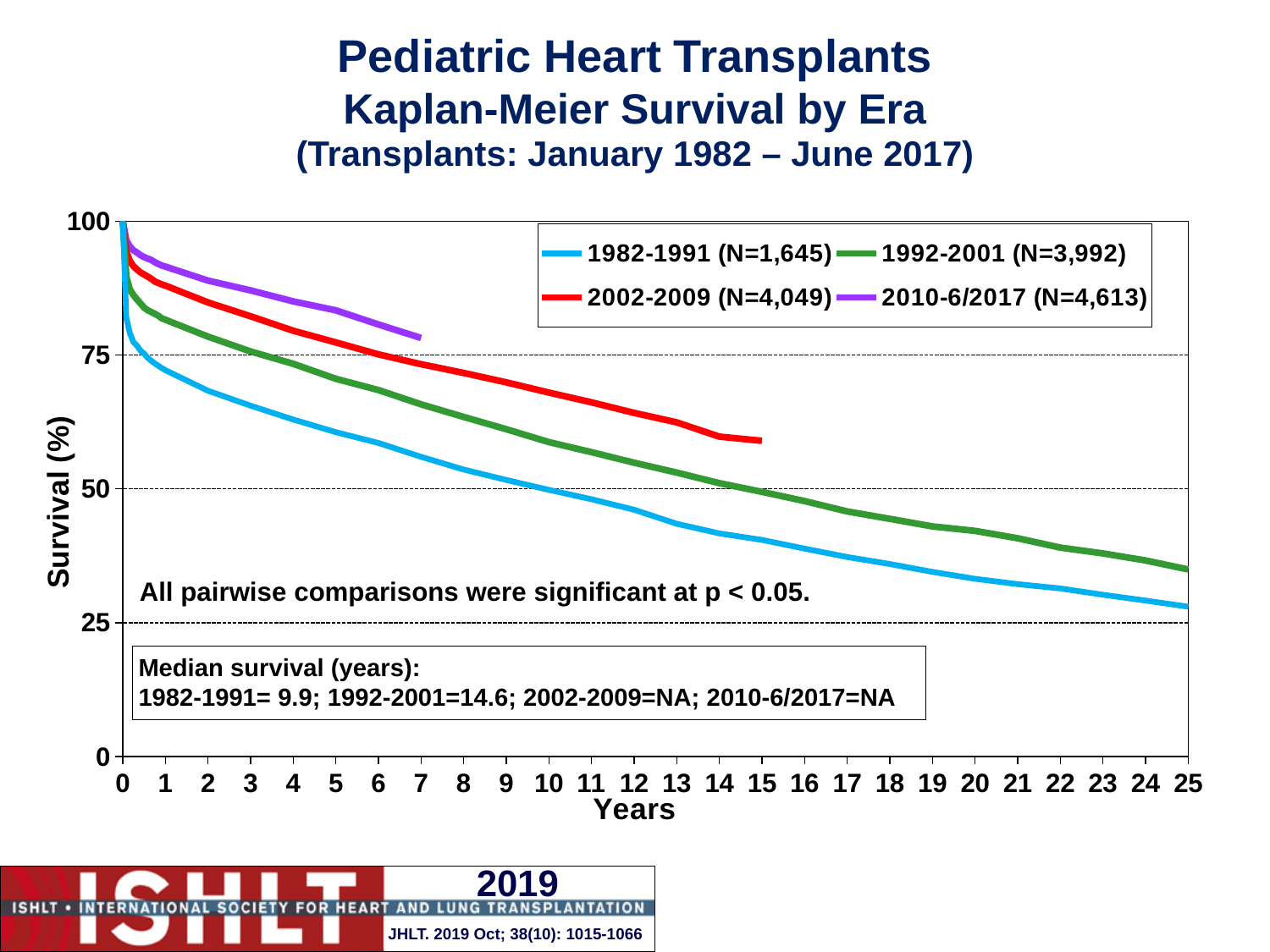
What kind of chart is shown on the slide? line chart What is the median survival in years for the 1992-2001 era? 14.6 How many series (eras) does the legend list? 4 What is the title of the chart on the slide? Pediatric Heart Transplants Kaplan-Meier Survival by Era (Transplants: January 1982 – June 2017) Which era has the lowest survival curve on the chart? 1982-1991 What is the median survival in years for the 1982-1991 era? 9.9 What is the N for the 2002-2009 era shown in the legend? N=4,049 Which era has the highest survival curve on the chart? 2010-6/2017 Is the survival for the 2002-2009 era at 15 years greater or less than 50%? greater Is the survival for the 1982-1991 era at 25 years greater or less than 50%? less What is the N for the 2010-6/2017 era shown in the legend? N=4,613 Do the survival curves rise or fall as years since transplant increase? fall